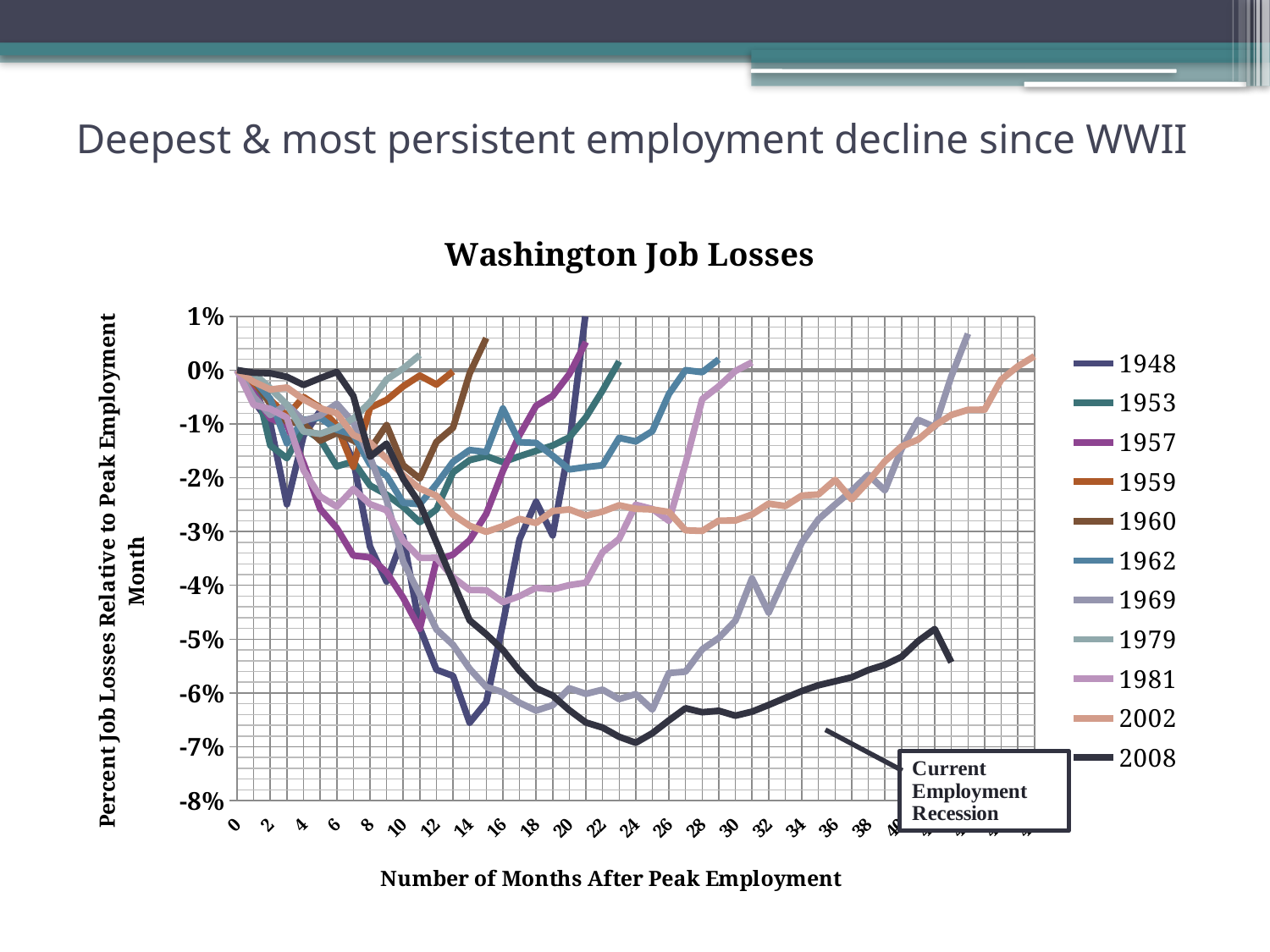
Which series reaches the lowest point on the chart? 2008 Is the value for the 2002 series at month 40 greater or less than -2%? greater Is the value for the 1957 series at month 12 greater or less than -4%? greater Does the 2002 series rise or fall between month 30 and month 48? rise What is the title of the chart? Washington Job Losses Is the value for the 2008 series at month 24 greater or less than -6%? less How many series does the legend of the Washington Job Losses chart list? 11 What is the x-axis title of the chart? Number of Months After Peak Employment Does the 2008 series rise or fall between month 0 and month 24? fall At month 24, which series has the larger value, 1981 or 2008? 1981 What kind of chart is shown on the slide? line chart